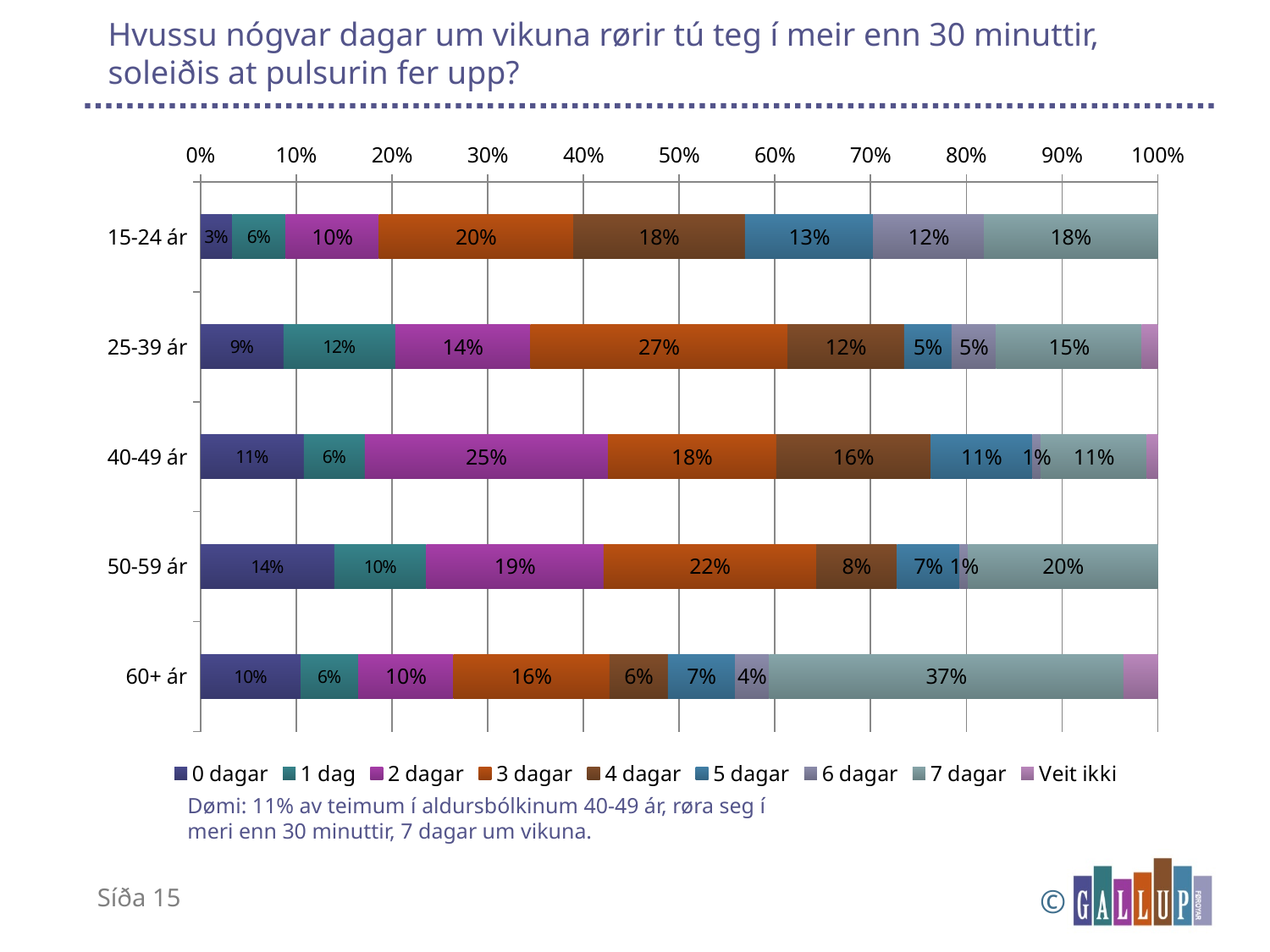
What is the value for 3 dagar in the 25-39 ár group? 27% What is the difference between the 3 dagar values for 25-39 ár and 60+ ár? 11% How many series does the legend list? 9 What percentage of the 60+ ár group reported 7 dagar? 37% What is the last entry in the chart's legend? Veit ikki What kind of chart is shown on the slide? Stacked bar chart What is the value for 0 dagar in the 15-24 ár group? 3% What percentage of the 40-49 ár group reported 7 dagar? 11% Which age group has the lowest share for 0 dagar? 15-24 ár Which age group has the highest share for 7 dagar? 60+ ár How many age groups are shown on the chart? 5 Which is larger: the 2 dagar value for 40-49 ár or for 50-59 ár? 40-49 ár